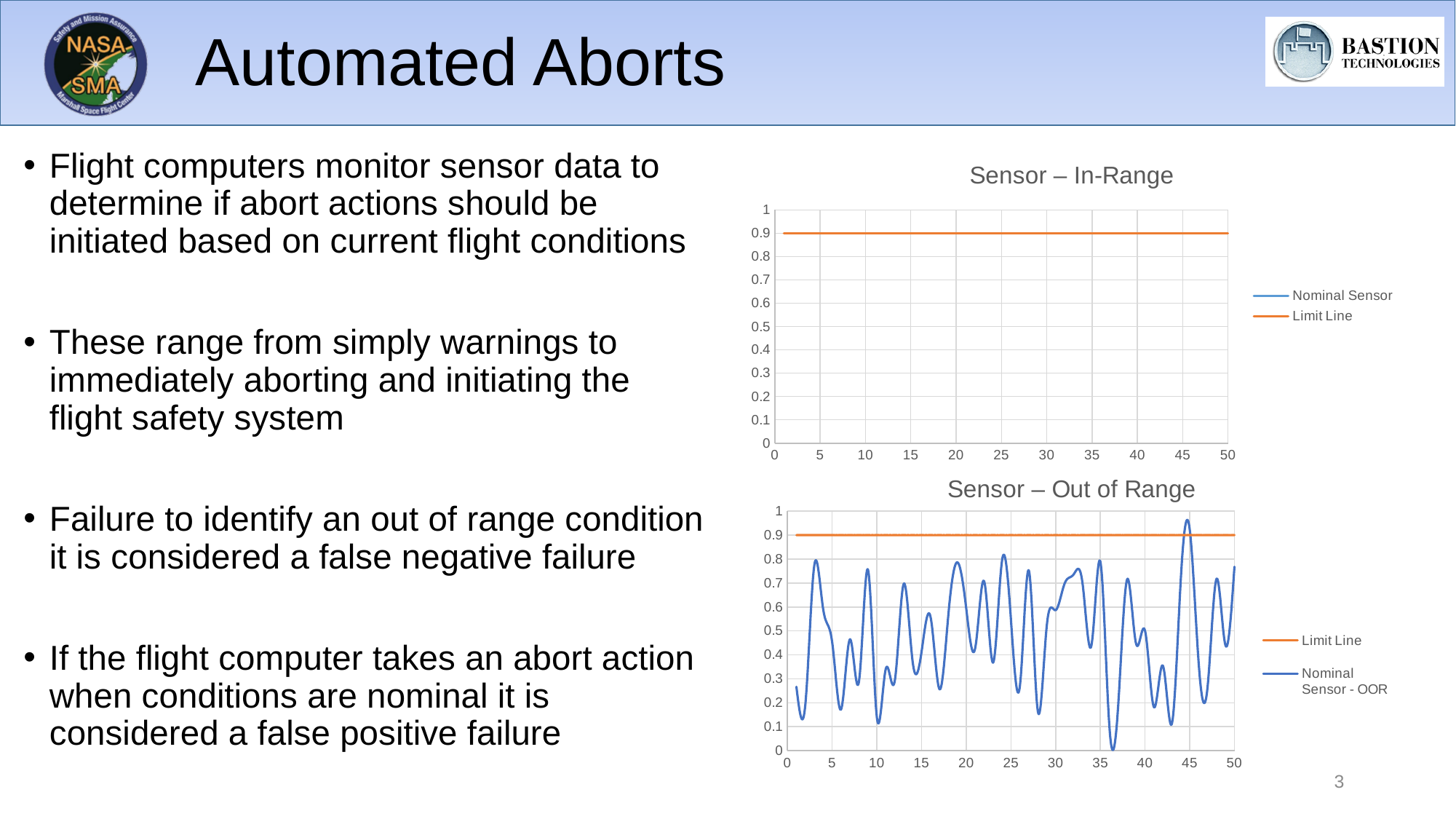
In the "Sensor – Out of Range" chart, is the Nominal Sensor - OOR value at x = 10 greater or less than 0.2? less In the "Sensor – In-Range" chart, at what value does the Limit Line sit on the y axis? 0.9 What kind of chart is the "Sensor – In-Range" chart? line chart What are the two legend entries of the "Sensor – Out of Range" chart? Limit Line and Nominal Sensor - OOR In the "Sensor – Out of Range" chart, is the peak value of the Nominal Sensor - OOR series near x = 45 greater or less than 0.9? greater What is the title of the lower chart on the slide? Sensor – Out of Range In the "Sensor – Out of Range" chart, does the Limit Line rise, fall, or stay flat along the x axis? stay flat What kind of chart is the "Sensor – Out of Range" chart? line chart How many series does the legend of the "Sensor – In-Range" chart list? 2 How many series does the legend of the "Sensor – Out of Range" chart list? 2 In the "Sensor – Out of Range" chart, at what value does the Limit Line sit on the y axis? 0.9